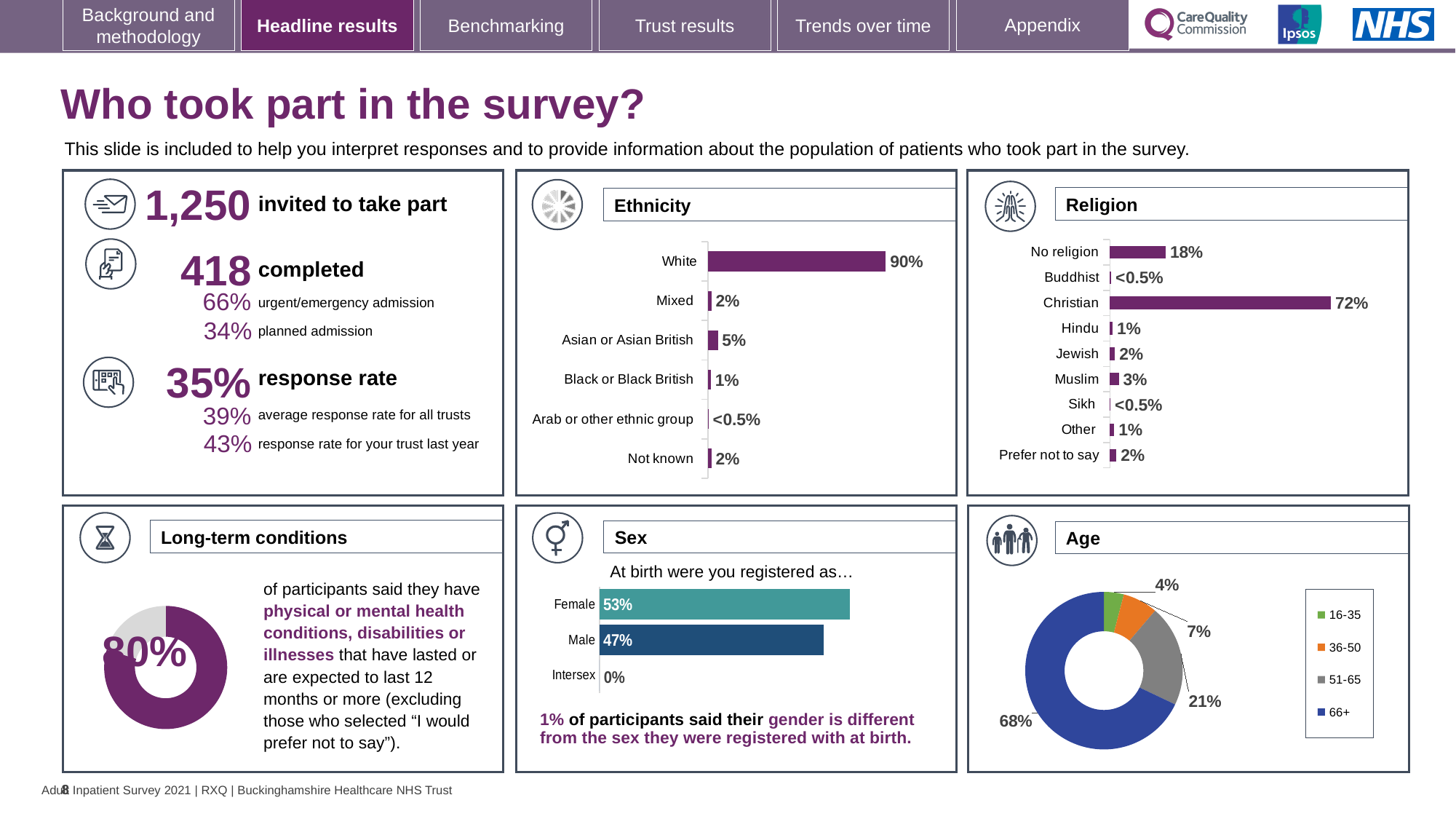
In the Ethnicity chart, which ethnic group has the lowest percentage? Arab or other ethnic group In the Religion chart, how many religion categories are listed? 9 In the Ethnicity chart, what percentage of participants were White? 90% In the Sex chart, what is the difference between the Female and Male percentages? 6% In the Religion chart, what percentage of participants were Christian? 72% In the Religion chart, which is larger, the percentage for Muslim or the percentage for Jewish? Muslim In the Ethnicity chart, what is the difference between the percentages for Asian or Asian British and Black or Black British? 4% In the Age chart, what share of participants were aged 66+? 68% In the Age chart, how many age groups does the legend list? 4 In the Ethnicity chart, how many ethnic group categories are shown? 6 In the Religion chart, which category has the highest percentage? Christian In the Sex chart, what percentage of participants were registered as Male at birth? 47%